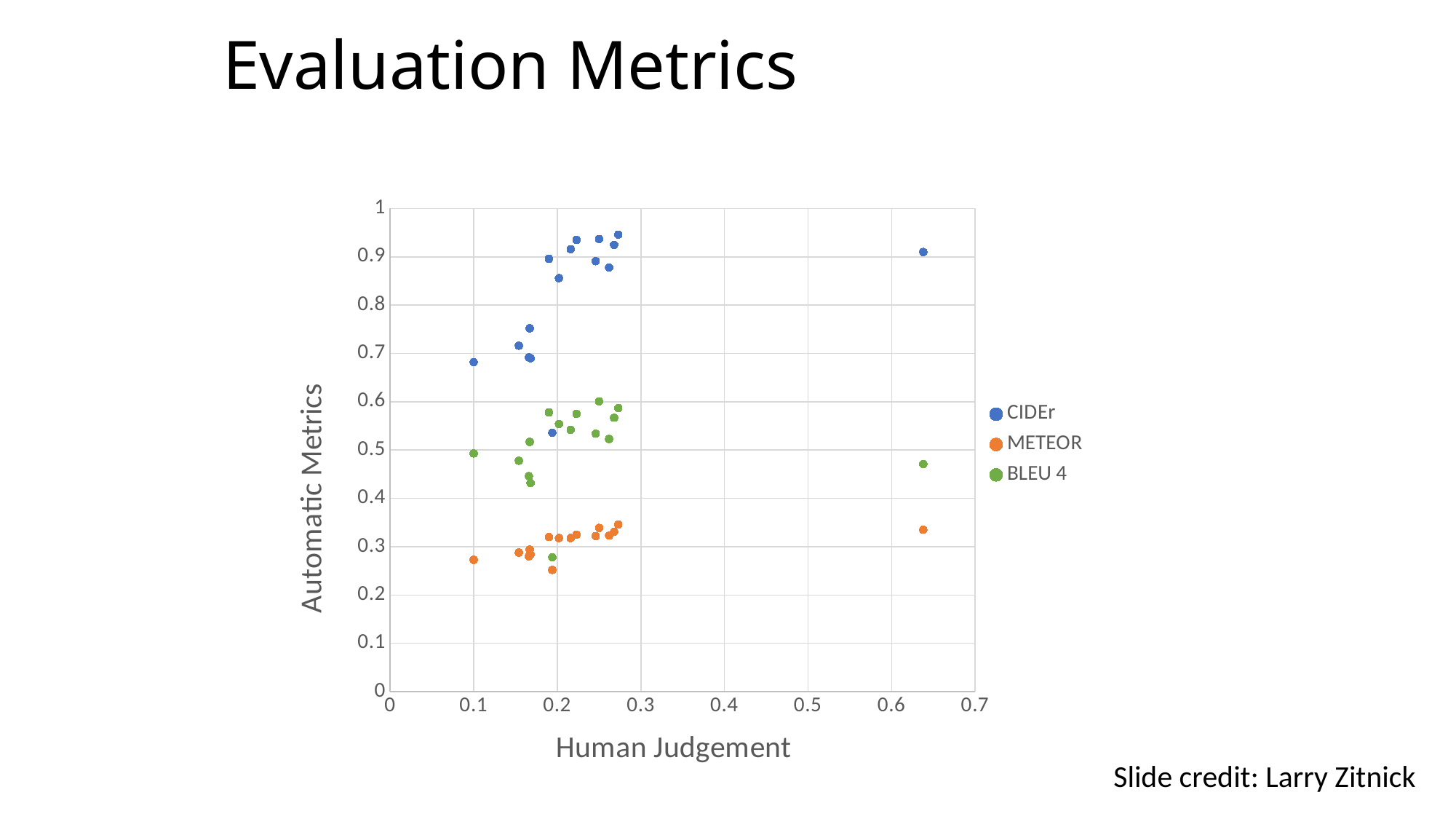
Is the BLEU 4 value at Human Judgement 0.64 greater or less than 0.5? less At Human Judgement 0.64, which is larger, the CIDEr value or the BLEU 4 value? CIDEr Do the CIDEr values generally rise or fall as Human Judgement increases from 0.1 to 0.3? rise What is the title of the vertical axis? Automatic Metrics Is the CIDEr value at Human Judgement 0.64 greater or less than 0.8? greater Which series has the lowest Automatic Metrics values overall? METEOR How many series does the legend list? 3 What kind of chart is shown on the slide? Scatter chart What is the title of the horizontal axis? Human Judgement Is the CIDEr value at Human Judgement 0.1 greater or less than 0.6? greater Which series has the highest Automatic Metrics values overall? CIDEr